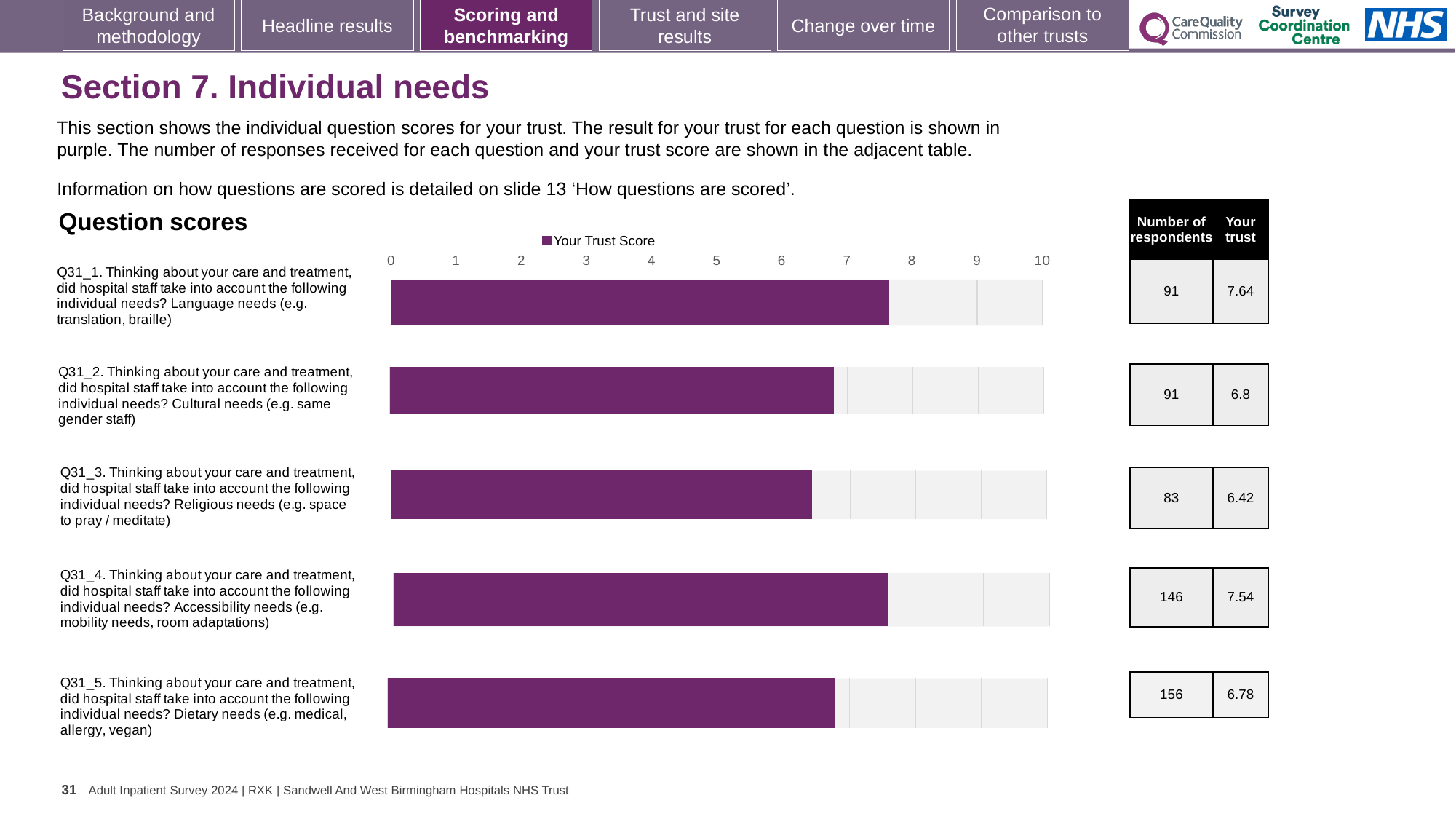
Which question has the lowest trust score? Q31_3 (Religious needs) Is the trust score for Q31_5 (Dietary needs) greater or less than 7? less Which has a higher trust score, Q31_2 (Cultural needs) or Q31_4 (Accessibility needs)? Q31_4 (Accessibility needs) How many respondents answered Q31_4 (Accessibility needs)? 146 What is the trust score for Q31_1 (Language needs)? 7.64 What is the trust score for Q31_5 (Dietary needs)? 6.78 What is the trust score for Q31_3 (Religious needs)? 6.42 What is the difference between the trust scores for Q31_1 and Q31_3? 1.22 What type of chart is shown? Bar chart Which question has the highest trust score? Q31_1 (Language needs) How many questions are plotted in the chart? 5 What series does the chart legend list? Your Trust Score